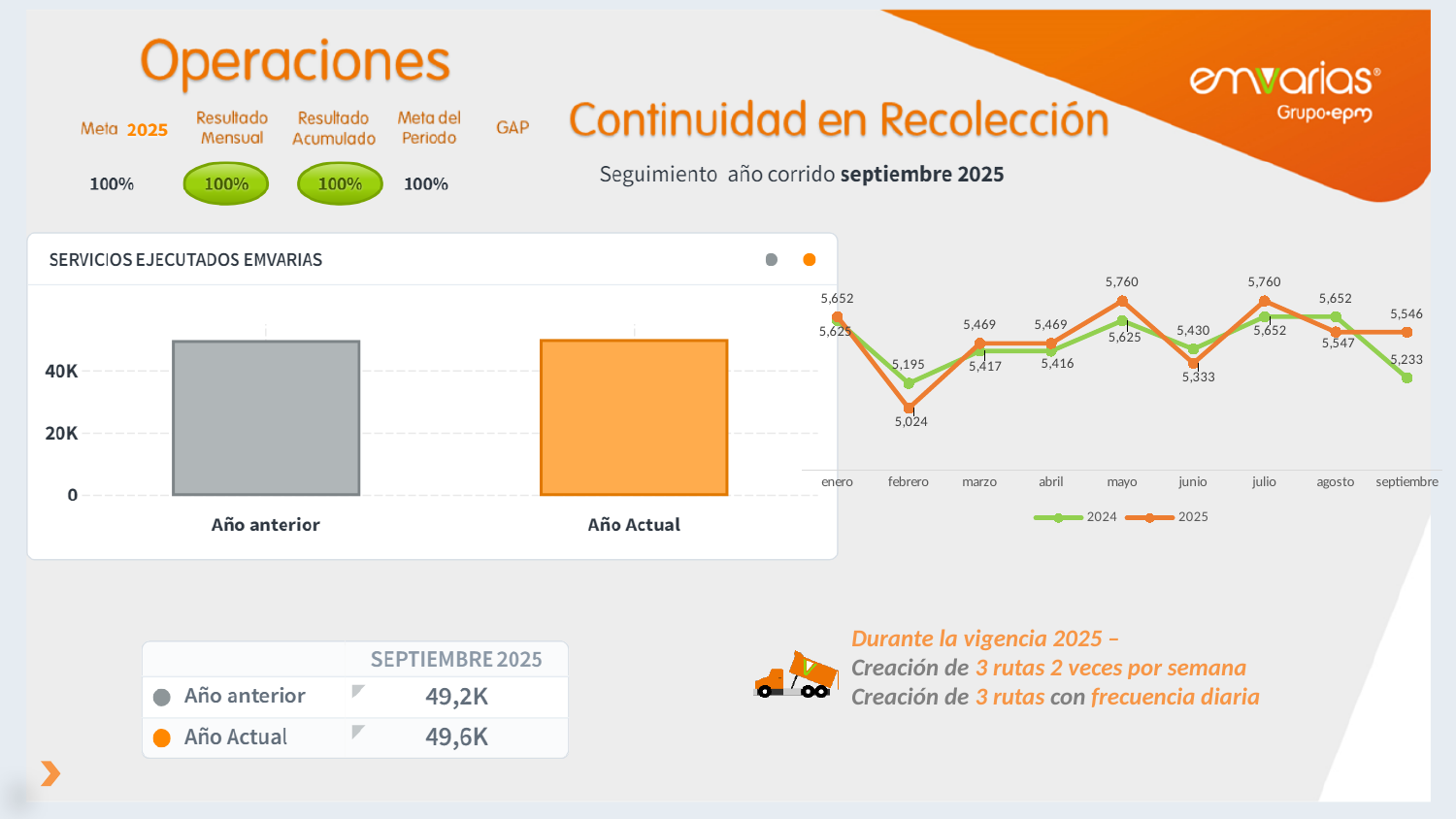
In the line chart on the right, what is the value for 2025 in septiembre? 5,546 In the line chart on the right, which month has the lowest value for 2024? febrero In the 'SERVICIOS EJECUTADOS EMVARIAS' chart, is the value for Año Actual greater or less than 40K? greater In the line chart on the right, what is the value for 2025 in mayo? 5,760 What kind of chart is the 'SERVICIOS EJECUTADOS EMVARIAS' chart? bar chart In the line chart on the right, what is the value for 2024 in febrero? 5,195 In the line chart on the right, what is the difference between the 2025 and 2024 values in septiembre? 313 In the 'SERVICIOS EJECUTADOS EMVARIAS' chart, what colour is the Año Actual bar? orange In the line chart on the right, which series has the larger value in junio, 2024 or 2025? 2024 In the line chart on the right, how many months are shown on the x axis? 9 In the line chart on the right, how many series does the legend list? 2 In the line chart on the right, which month has the lowest value for 2025? febrero